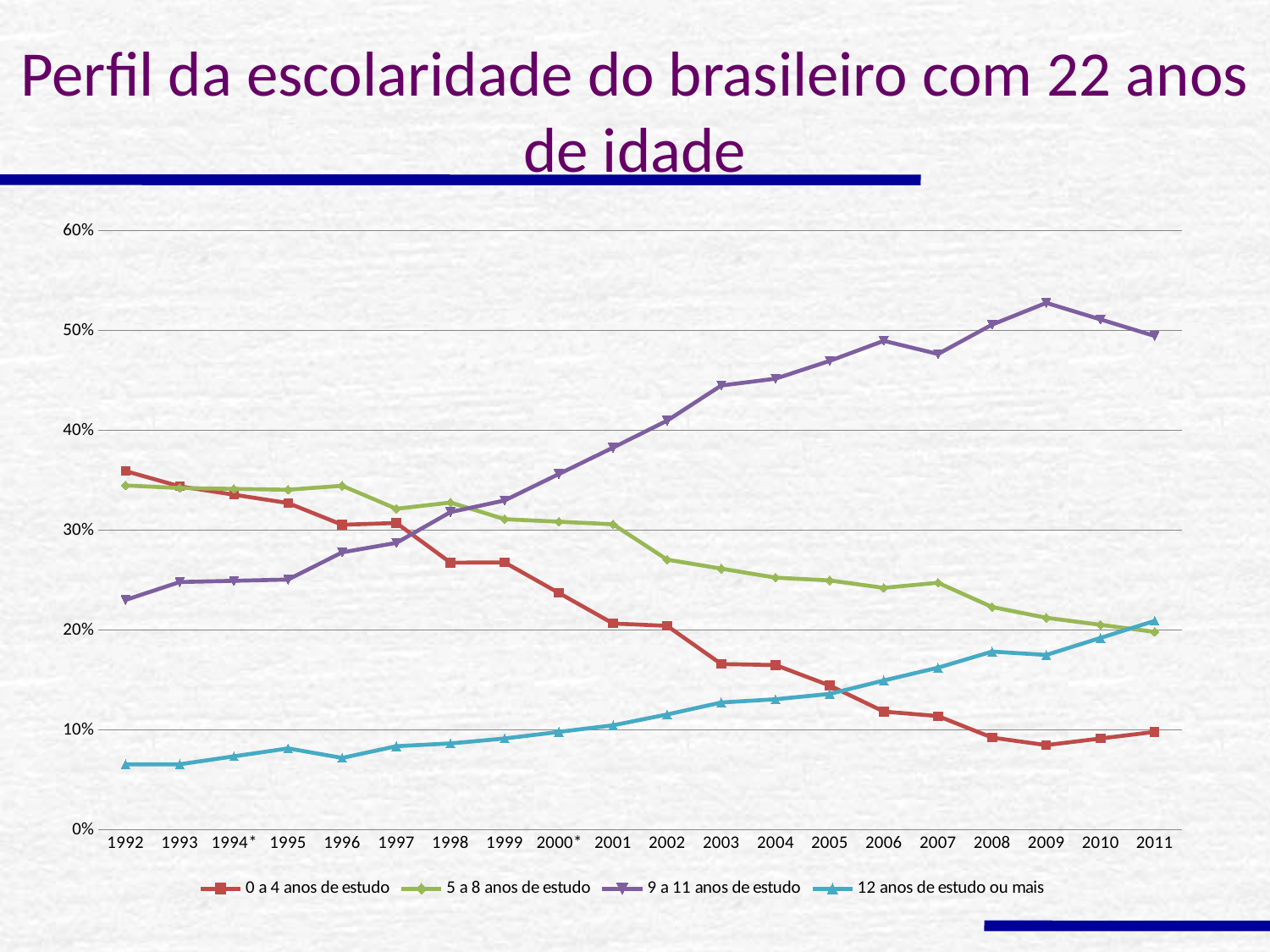
How many years are shown on the x axis? 20 Which series has the highest value in 2011? 9 a 11 anos de estudo Does the '0 a 4 anos de estudo' series generally rise or fall from 1992 to 2011? Fall Does the '9 a 11 anos de estudo' series generally rise or fall from 1992 to 2011? Rise Is the value for '0 a 4 anos de estudo' in 1992 greater or less than 30%? greater In which year does the '9 a 11 anos de estudo' series reach its highest value? 2009 How many series does the legend list? 4 What is the title of the slide? Perfil da escolaridade do brasileiro com 22 anos de idade In 2011, which is larger: '12 anos de estudo ou mais' or '0 a 4 anos de estudo'? 12 anos de estudo ou mais Which series has the lowest value in 1992? 12 anos de estudo ou mais Is the value for '9 a 11 anos de estudo' in 2009 greater or less than 50%? greater What kind of chart is shown on the slide? Line chart